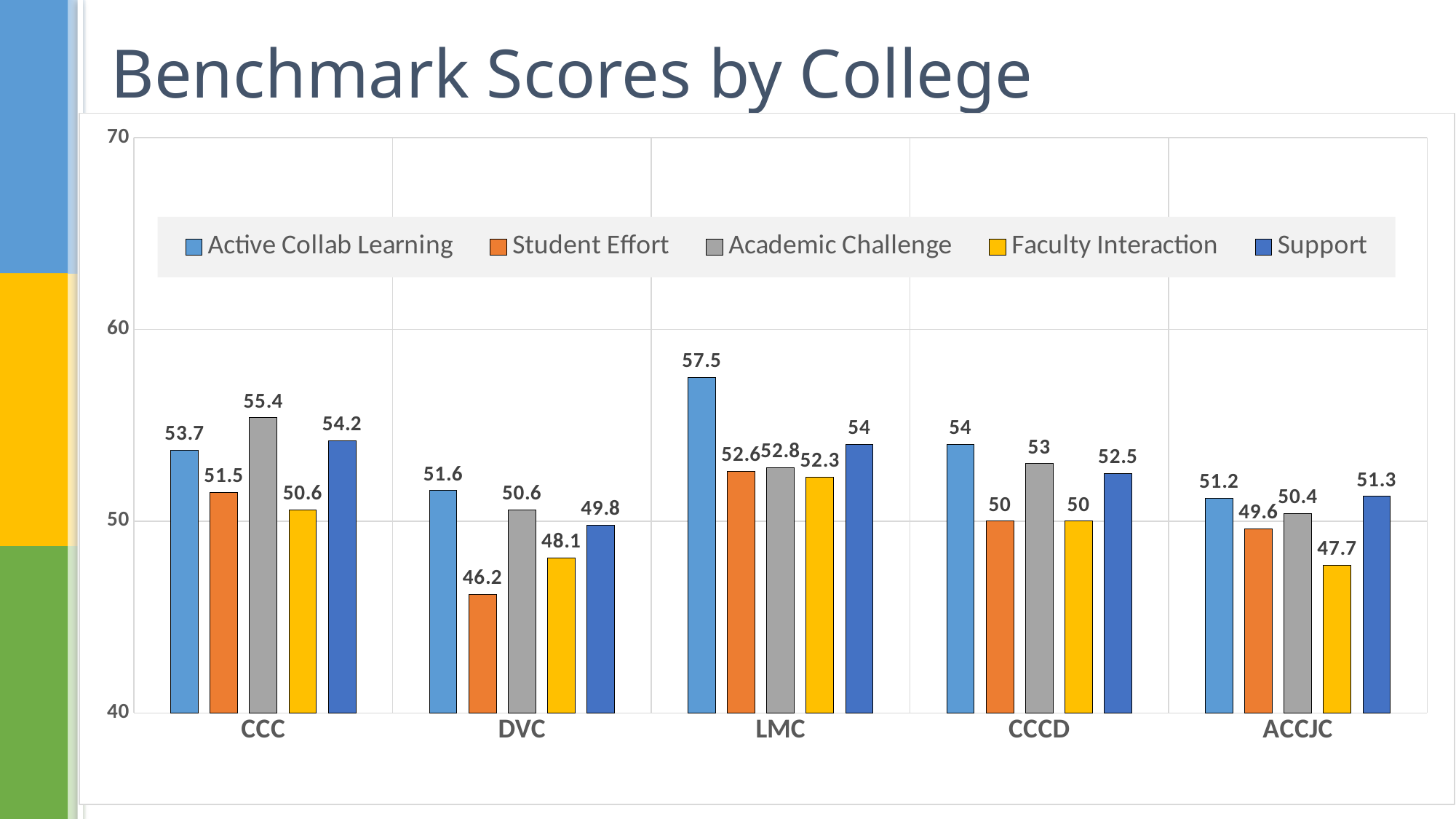
What is the Faculty Interaction score for ACCJC? 47.7 What is the Active Collab Learning score for LMC? 57.5 What kind of chart is shown on the slide? bar chart How many series does the legend list? 5 What is the difference between the Academic Challenge scores for CCC and DVC? 4.8 Which college has the lowest Student Effort score? DVC Which is larger, the Support score for CCC or the Support score for DVC? CCC What is the Student Effort score for DVC? 46.2 How many colleges are shown on the x axis? 5 Is the Faculty Interaction score for DVC greater or less than 50? less What is the Support score for CCCD? 52.5 Which college has the highest Active Collab Learning score? LMC